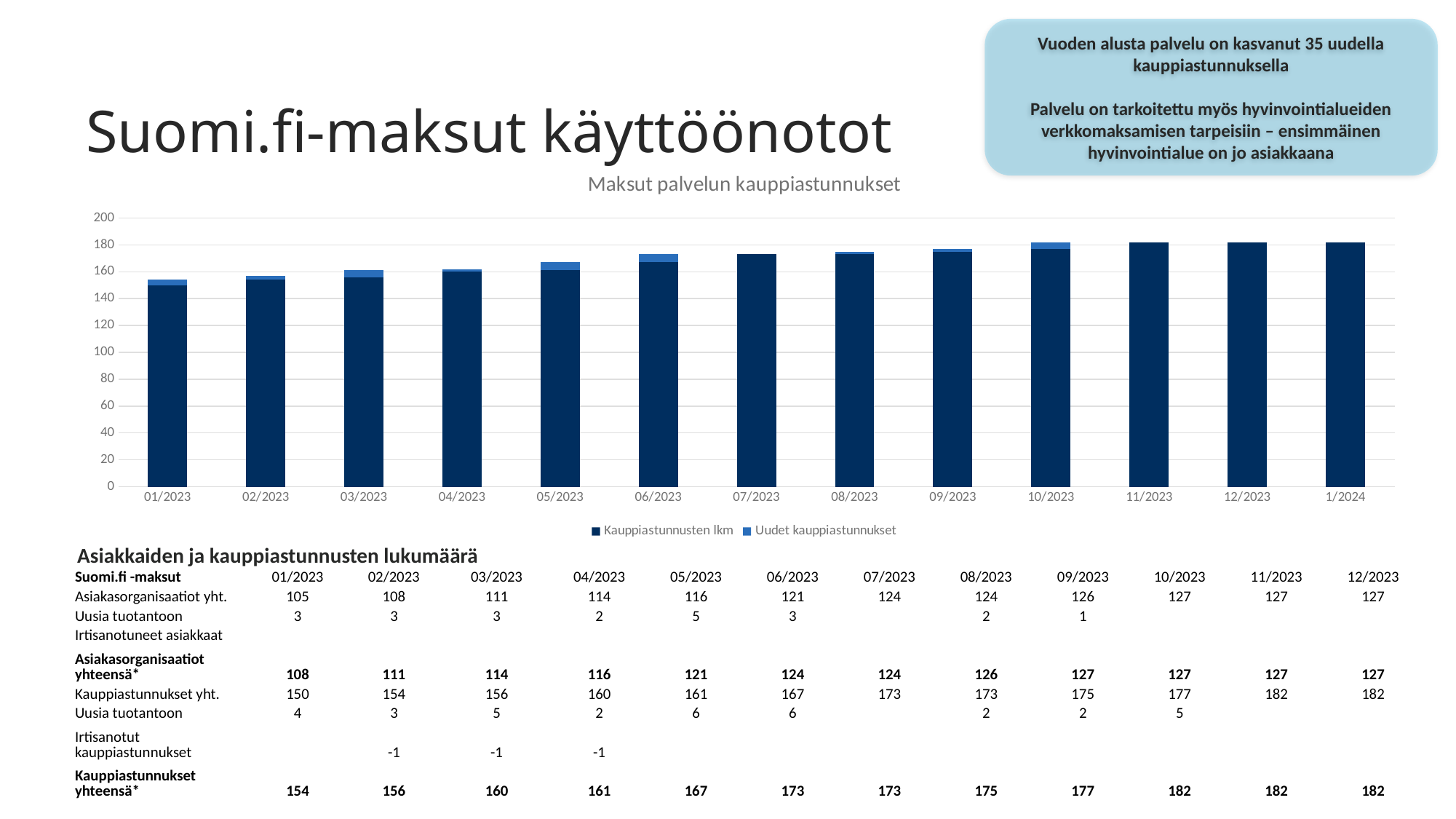
Do the bar heights generally rise or fall from 01/2023 to 1/2024? rise How many series does the chart legend list? 2 Which has the taller total bar, 06/2023 or 01/2023? 06/2023 Which has the taller total bar, 12/2023 or 03/2023? 12/2023 What kind of chart is shown on the slide? bar chart What is the title of the chart? Maksut palvelun kauppiastunnukset What are the two series named in the chart legend? Kauppiastunnusten lkm and Uudet kauppiastunnukset How many months (categories) are shown on the x axis of the chart? 13 Is the total bar height for 07/2023 greater or less than 160? greater Is the Kauppiastunnusten lkm value for 01/2023 greater or less than 160? less